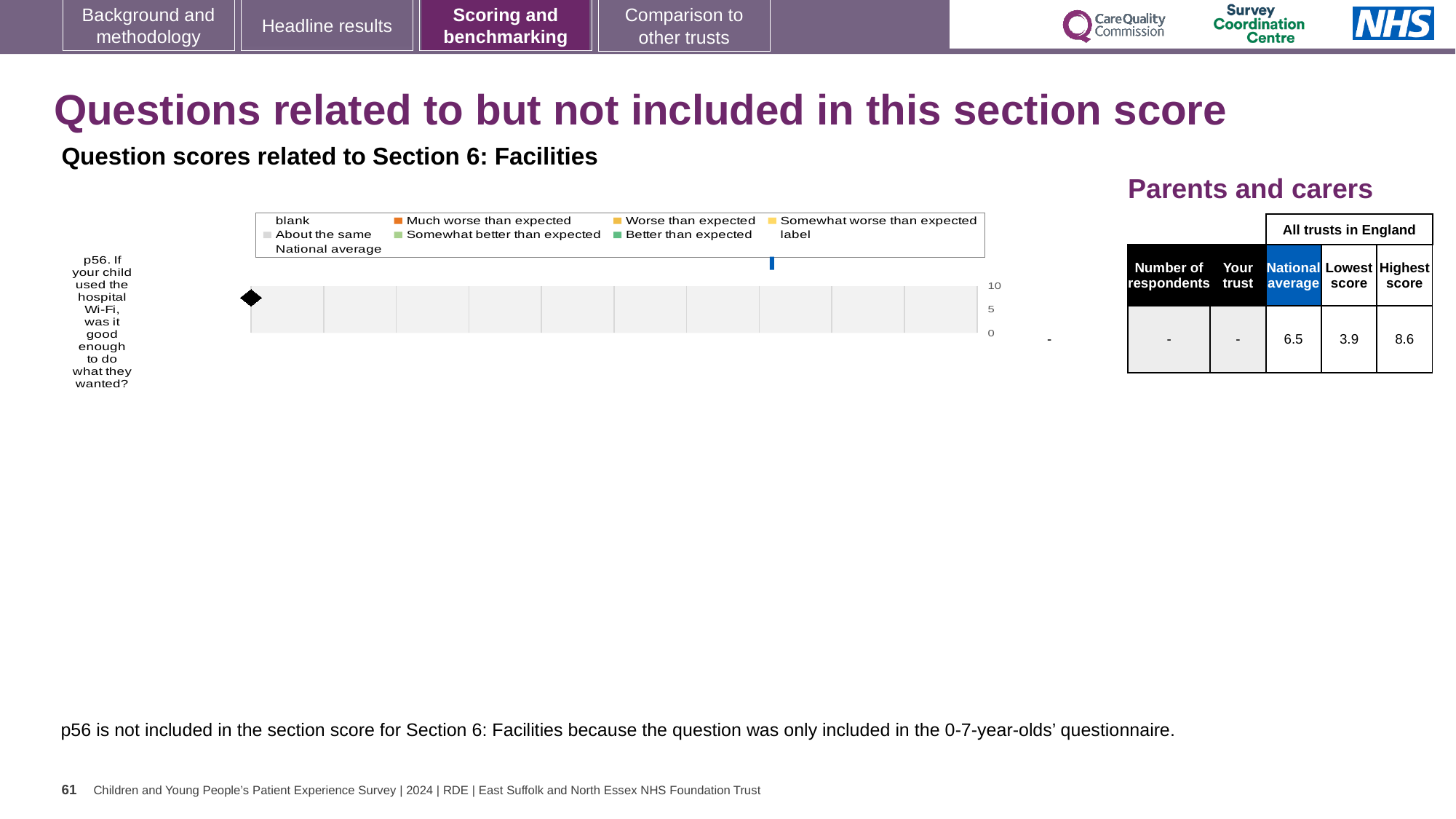
What value is shown for Your trust for p56 in the table? - Which question number is shown on the chart's category axis? p56 In the table, what is the Highest score across all trusts in England for p56? 8.6 What is the maximum value shown on the chart's score axis? 10 In the table, what is the Lowest score across all trusts in England for p56? 3.9 In the table, what is the National average score for p56? 6.5 Is the National average score for p56 greater or less than 5? greater What is the difference between the Highest score and the Lowest score for p56 in the table? 4.7 Which is larger for p56: the National average or the Lowest score? National average How many survey questions are plotted on the chart? 1